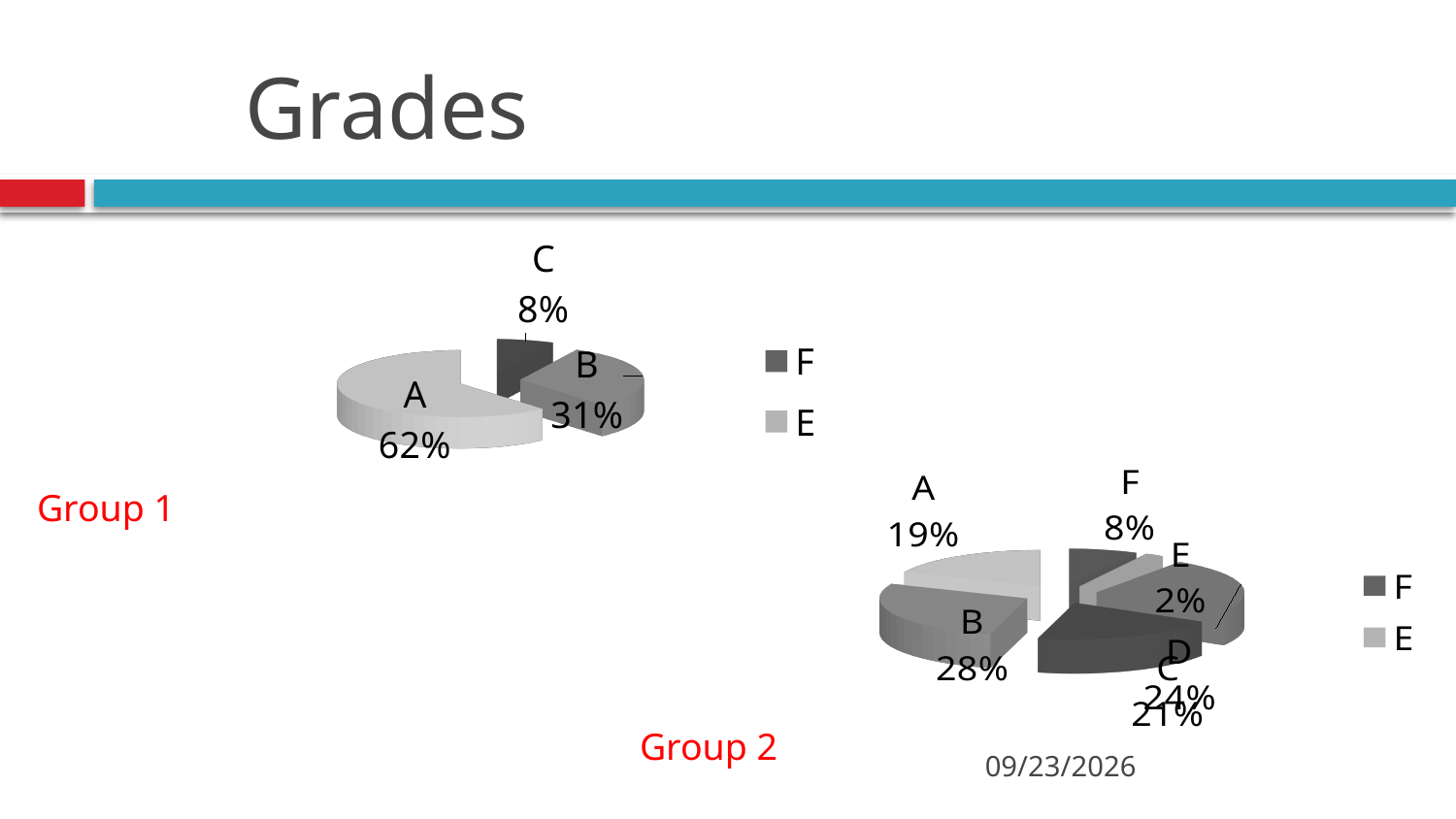
In the Group 1 chart, what percentage is grade B? 31% In the Group 2 chart, which is larger, the share of grade A or the share of grade F? A In the Group 2 chart, which grade has the smallest share? E In the Group 2 chart, what percentage is grade A? 19% What kind of chart is used for Group 1? Pie chart In the Group 2 chart, what percentage is grade E? 2% In the Group 2 chart, what percentage is grade B? 28% In the Group 1 chart, what percentage is grade C? 8% In the Group 2 chart, which grade has the largest share? B In the Group 1 chart, what is the difference between the shares of grade A and grade B? 31% In the Group 1 chart, which grade has the largest share? A In the Group 1 chart, what percentage is grade A? 62%